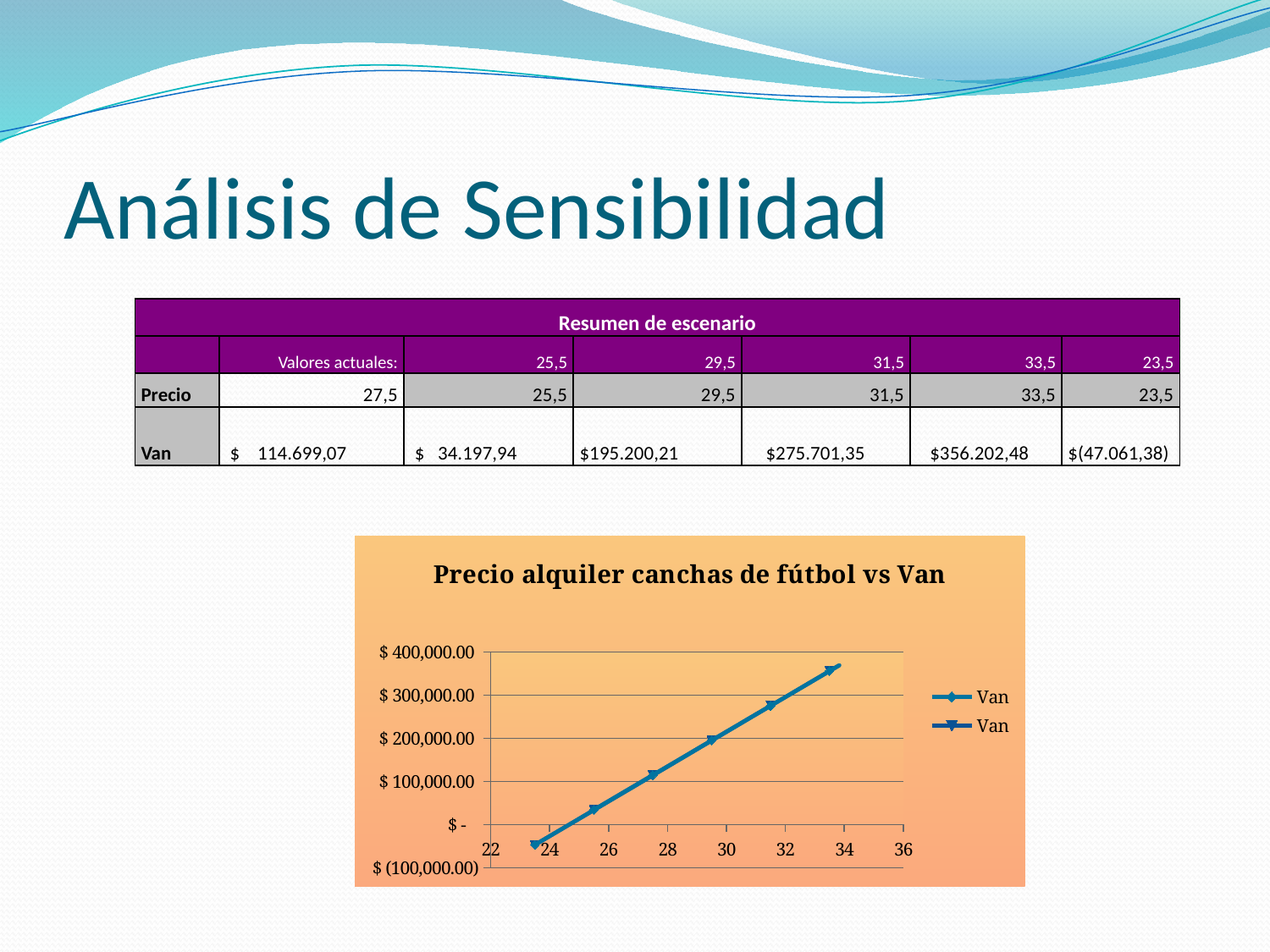
How many data points are plotted in the chart 'Precio alquiler canchas de fútbol vs Van'? 6 What kind of chart is shown under the title 'Precio alquiler canchas de fútbol vs Van'? line chart In the chart 'Precio alquiler canchas de fútbol vs Van', is the Van value of the rightmost point greater or less than $ 300,000.00? greater In the chart 'Precio alquiler canchas de fútbol vs Van', is the Van value of the second point from the right greater or less than $ 300,000.00? less What is the title of the chart on the slide? Precio alquiler canchas de fútbol vs Van In the chart 'Precio alquiler canchas de fútbol vs Van', which point has the lowest Van value? the leftmost point (lowest price) How many entries does the legend of the chart 'Precio alquiler canchas de fútbol vs Van' list? 2 What is the highest tick label shown on the y axis of the chart 'Precio alquiler canchas de fútbol vs Van'? $ 400,000.00 In the chart 'Precio alquiler canchas de fútbol vs Van', which point has the highest Van value? the rightmost point (highest price) In the chart 'Precio alquiler canchas de fútbol vs Van', do the Van values rise or fall as the price increases along the x axis? rise In the chart 'Precio alquiler canchas de fútbol vs Van', is the Van value of the leftmost point greater or less than $ -? less